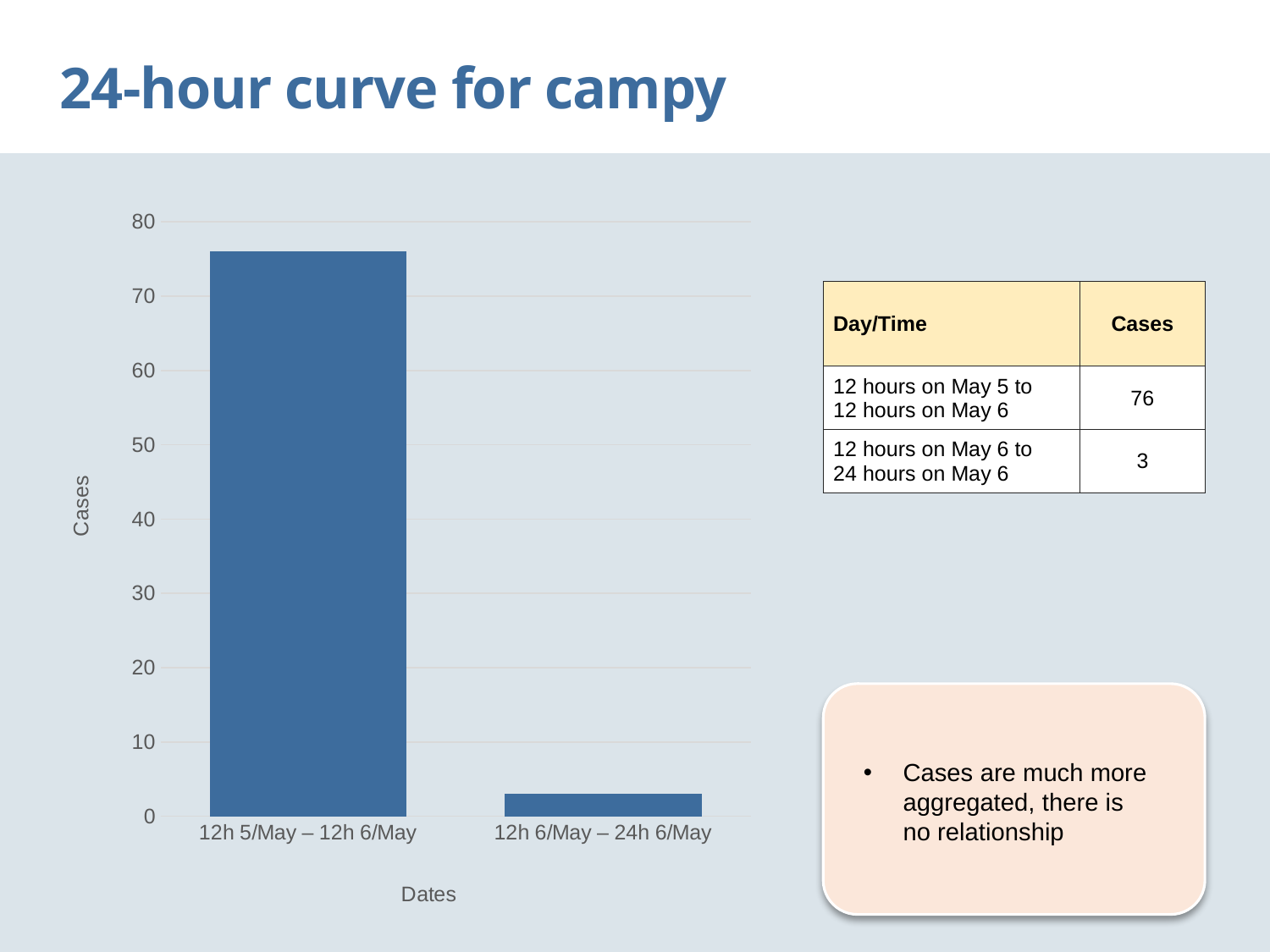
Which has more cases: 12h 5/May – 12h 6/May or 12h 6/May – 24h 6/May? 12h 5/May – 12h 6/May Is the number of cases for 12h 6/May – 24h 6/May greater or less than 10? less What is the difference in cases between the two periods shown on the slide? 73 How many cases does the slide report for 12 hours on May 6 to 24 hours on May 6? 3 What is the label of the y axis of the chart? Cases Is the number of cases for 12h 5/May – 12h 6/May greater or less than 70? greater How many cases does the slide report for 12 hours on May 5 to 12 hours on May 6? 76 Do the values rise or fall from the first bar to the second bar along the x axis? fall Which period has the lowest number of cases in the chart? 12h 6/May – 24h 6/May What kind of chart is shown on the slide? bar chart How many bars (categories) does the chart show? 2 Which period has the highest number of cases in the chart? 12h 5/May – 12h 6/May